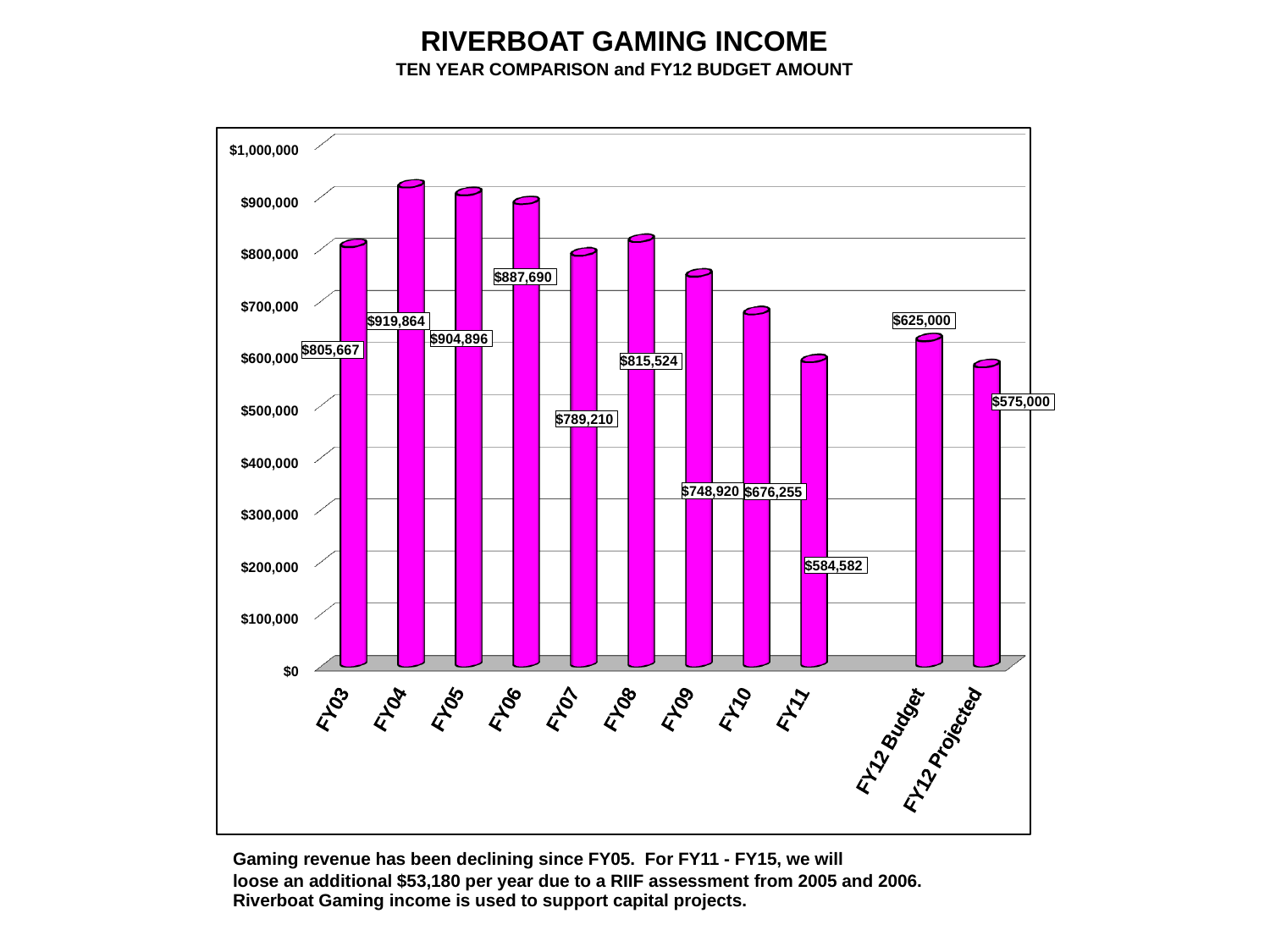
What is the difference between the FY04 and FY03 values? $114,197 Which fiscal year has the highest value? FY04 How many bars are shown in the chart? 11 What is the value for FY03? $805,667 What is the difference between the FY12 Budget and FY12 Projected values? $50,000 What is the value for FY09? $748,920 Is the value for FY10 greater or less than $700,000? less Which is larger, the value for FY07 or the value for FY08? FY08 Do the values rise or fall from FY04 through FY11? fall What is the value for FY12 Budget? $625,000 Which category has the lowest value? FY12 Projected What kind of chart is this? bar chart